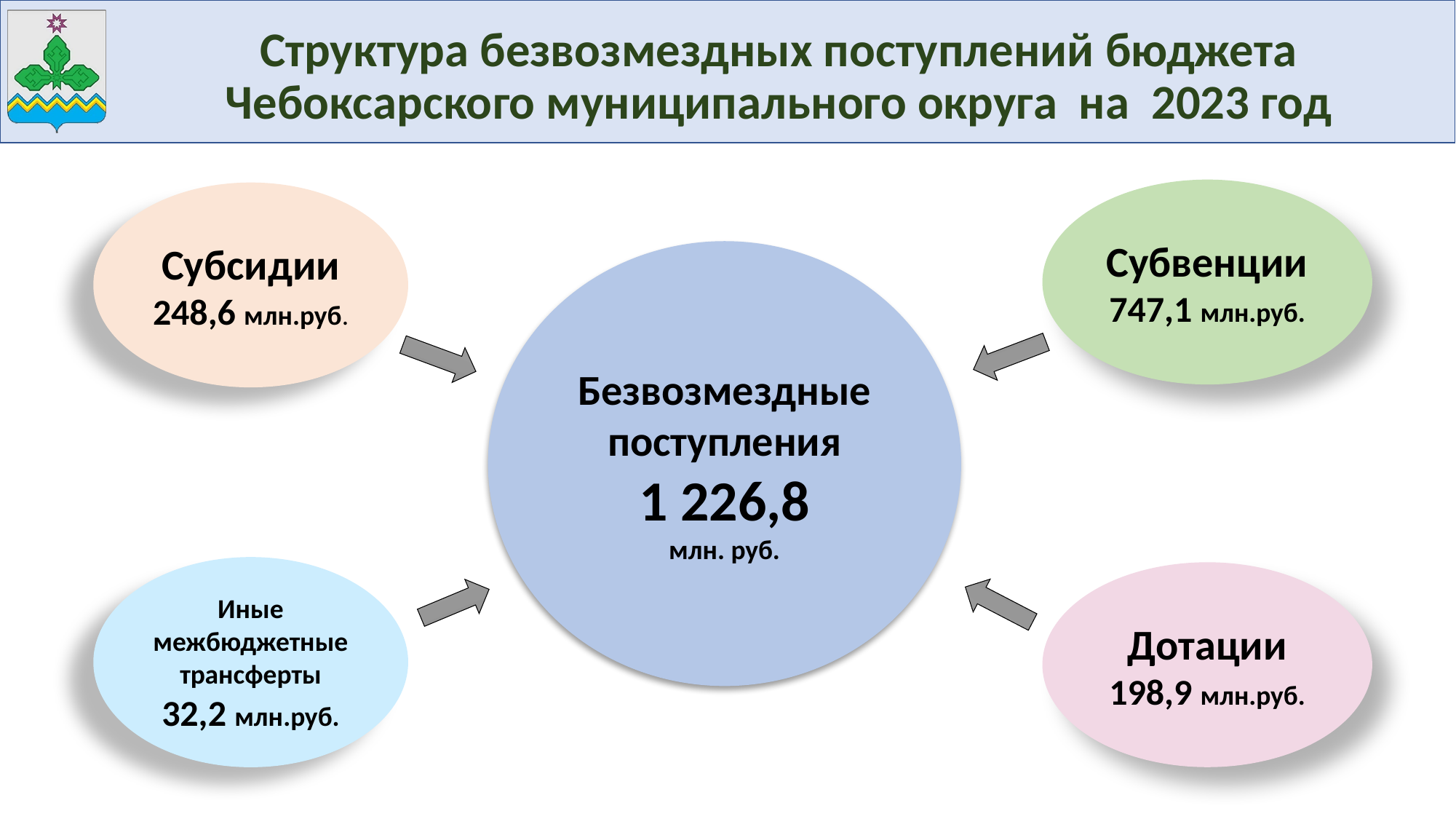
What is the value shown for Субвенции? 747,1 млн.руб. What is the difference between the values for Субсидии and Дотации? 49,7 млн.руб. What year does the diagram title refer to? 2023 What is the value shown for Дотации? 198,9 млн.руб. What is the value shown for Иные межбюджетные трансферты? 32,2 млн.руб. Which component of the безвозмездные поступления has the lowest value? Иные межбюджетные трансферты How many components of безвозмездные поступления are shown around the central circle? 4 What is the difference between the values for Субвенции and Субсидии? 498,5 млн.руб. What is the total value of Безвозмездные поступления shown in the central circle? 1 226,8 млн. руб. Which is larger, the value for Дотации or the value for Субсидии? Субсидии Which component of the безвозмездные поступления has the highest value? Субвенции What is the value shown for Субсидии? 248,6 млн.руб.